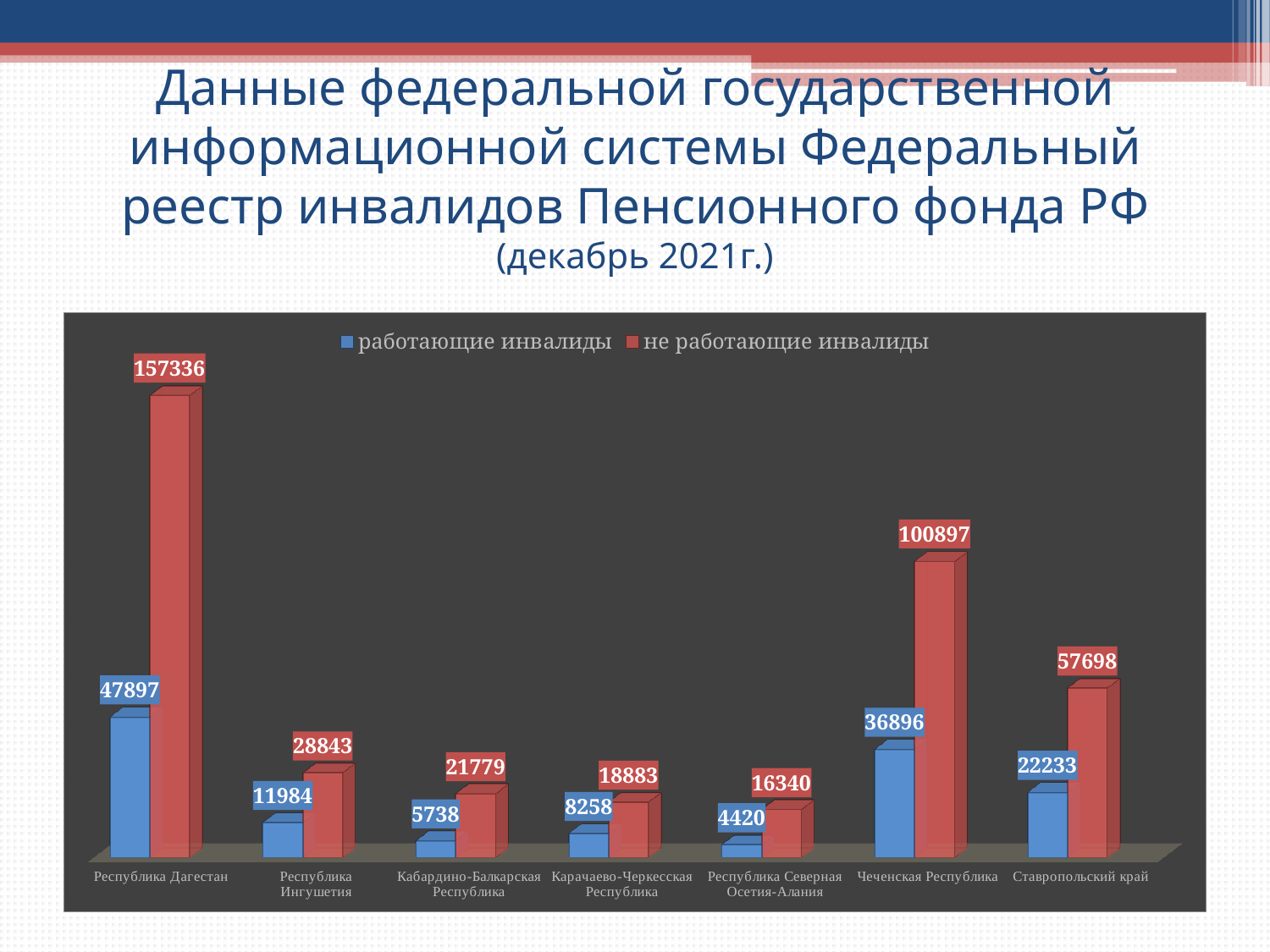
What is the value for не работающие инвалиды in Чеченская Республика? 100897 What kind of chart is shown on the slide? Bar chart How many series does the legend list? 2 What is the value for не работающие инвалиды in Ставропольский край? 57698 Which colour represents не работающие инвалиды in the chart? Red Which is larger: работающие инвалиды in Чеченская Республика or работающие инвалиды in Ставропольский край? Чеченская Республика How many regions are shown on the x axis of the chart? 7 Which region has the lowest value for работающие инвалиды? Республика Северная Осетия-Алания What is the value for работающие инвалиды in Кабардино-Балкарская Республика? 5738 What is the difference between не работающие инвалиды and работающие инвалиды in Республика Ингушетия? 16859 Which region has the highest value for не работающие инвалиды? Республика Дагестан What is the value for работающие инвалиды in Республика Дагестан? 47897